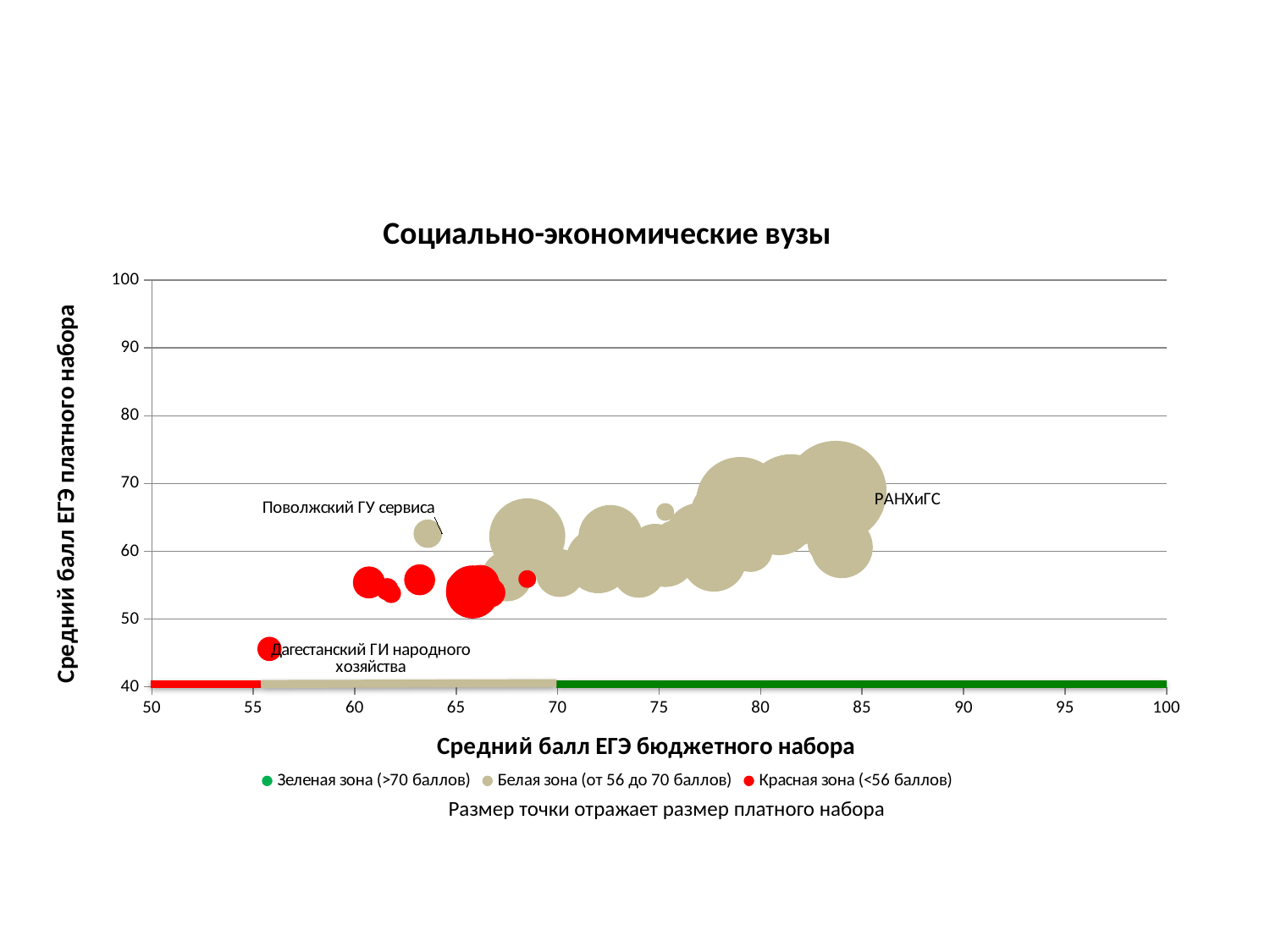
Is the value on the vertical axis (Средний балл ЕГЭ платного набора) for Дагестанский ГИ народного хозяйства greater or less than 50? less According to the note under the chart, what does the size of a point reflect? Размер платного набора Which has the higher value on the vertical axis (Средний балл ЕГЭ платного набора): РАНХиГС or Дагестанский ГИ народного хозяйства? РАНХиГС Is the value on the vertical axis (Средний балл ЕГЭ платного набора) for РАНХиГС greater or less than 60? greater What kind of chart is shown on the slide? Bubble chart Of the three labeled universities, which has the lowest value on the vertical axis (Средний балл ЕГЭ платного набора)? Дагестанский ГИ народного хозяйства Is the value on the horizontal axis (Средний балл ЕГЭ бюджетного набора) for РАНХиГС greater or less than 80? greater What is the title of the chart? Социально-экономические вузы How many series does the legend list? 3 Which has the higher value on the horizontal axis (Средний балл ЕГЭ бюджетного набора): Поволжский ГУ сервиса or РАНХиГС? РАНХиГС